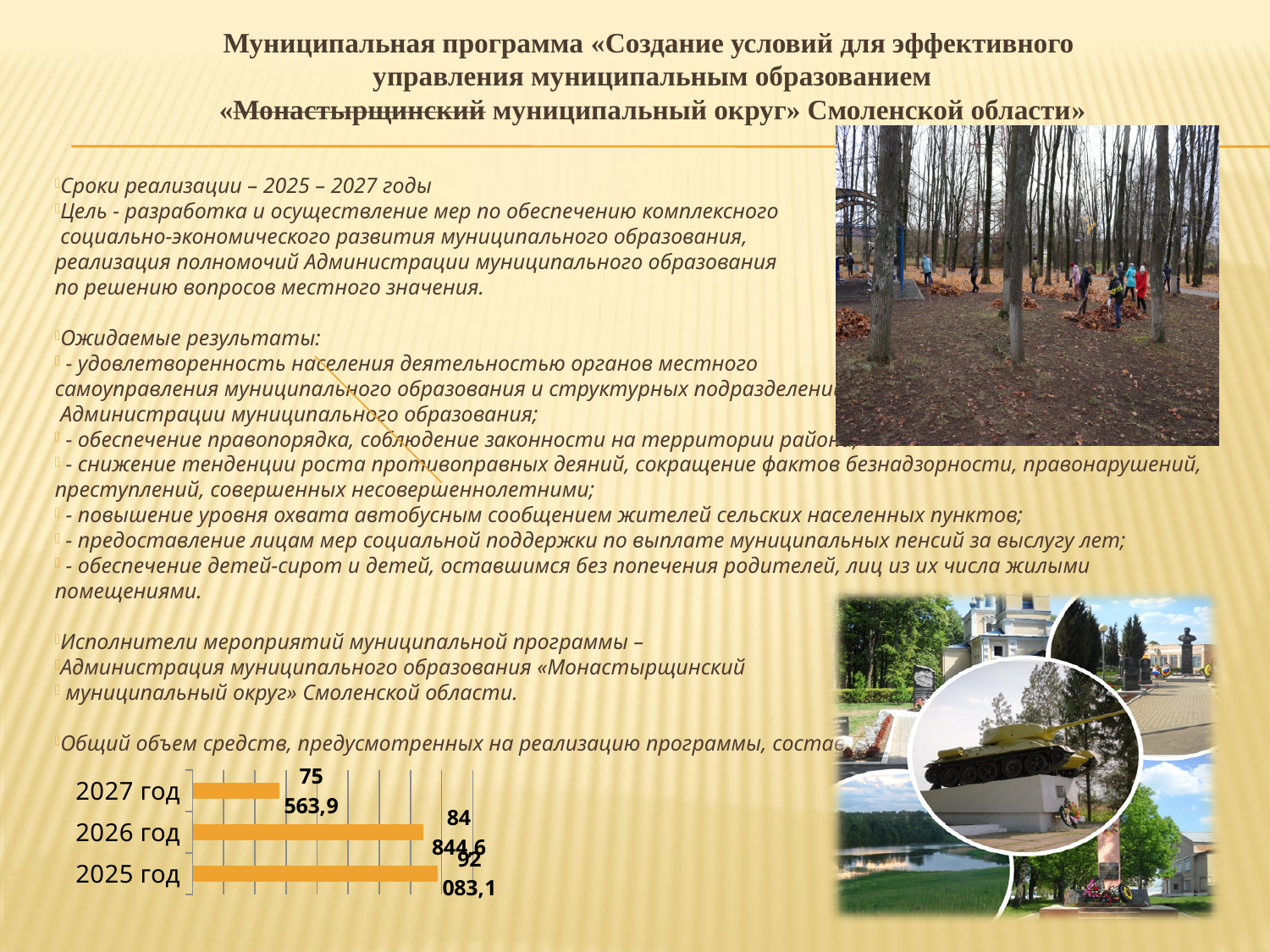
What is the difference between the values for 2025 год and 2027 год? 16 519,2 What is the value for 2027 год in the bar chart? 75 563,9 What is the value for 2026 год in the bar chart? 84 844,6 Which is larger, the value for 2026 год or the value for 2027 год? 2026 год What is the difference between the values for 2025 год and 2026 год? 7 238,5 What is the value for 2025 год in the bar chart? 92 083,1 Which year has the highest value in the bar chart? 2025 год What is the difference between the values for 2026 год and 2027 год? 9 280,7 Which year has the lowest value in the bar chart? 2027 год What kind of chart is shown at the bottom of the slide? bar chart How many categories (years) are shown in the bar chart? 3 Do the values in the chart rise or fall from 2025 год to 2027 год? fall